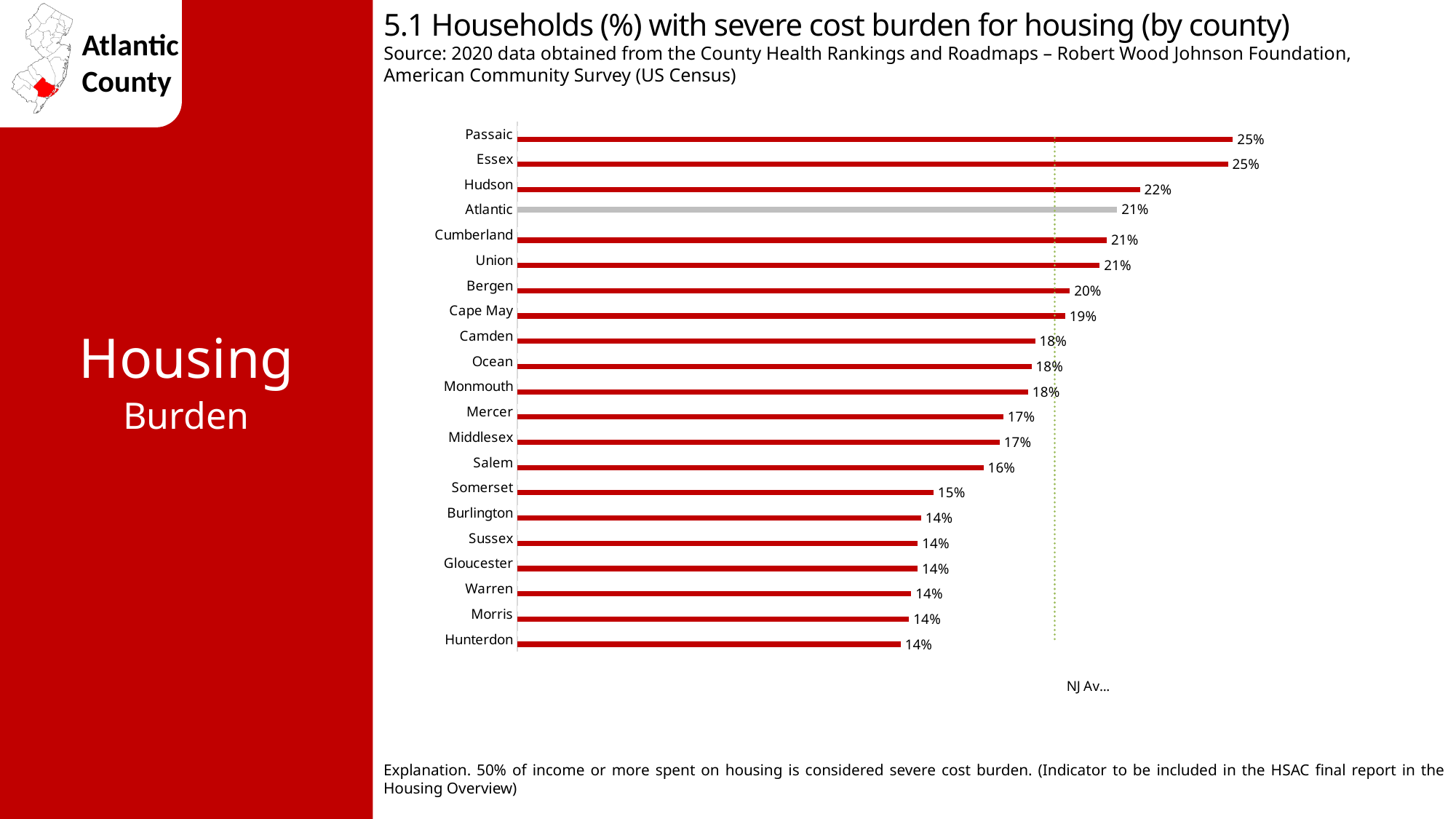
What is the value for Cape May? 19% What is the value for Hunterdon? 14% Which has a larger value, Hudson or Bergen? Hudson What is the difference between the values for Passaic and Hunterdon? 11 percentage points What is the difference between the values for Hudson and Atlantic? 1 percentage point What is the value for Somerset? 15% How many counties are shown on the chart? 21 What is the value for Atlantic County? 21% What is the value for Hudson County? 22% Which counties share the highest value on the chart? Passaic and Essex What kind of chart is shown on the slide? Bar chart Which county's bar is drawn in grey instead of red? Atlantic